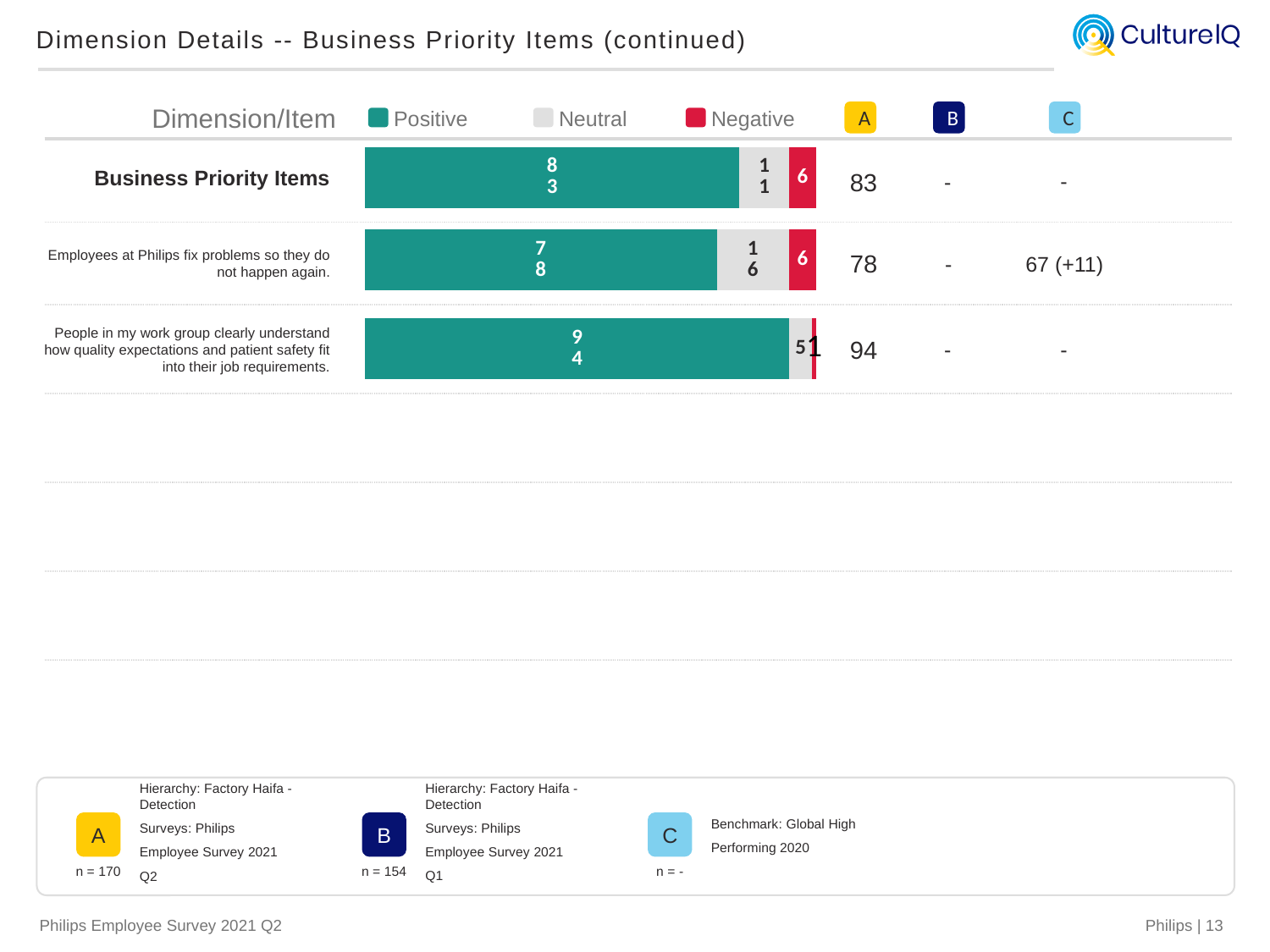
Which item has the highest Positive value? People in my work group clearly understand how quality expectations and patient safety fit into their job requirements. What is the Neutral value for "Employees at Philips fix problems so they do not happen again."? 16 Which item has the lowest Positive value? Employees at Philips fix problems so they do not happen again. How many rows (dimension/items) are plotted in the chart? 3 What value is shown in column C for "Employees at Philips fix problems so they do not happen again."? 67 (+11) What is the Positive value for "Business Priority Items"? 83 What is the total of the stacked bar for "Employees at Philips fix problems so they do not happen again."? 100 What kind of chart is shown on the slide? Stacked bar chart What is the difference between the Positive values for "People in my work group clearly understand how quality expectations and patient safety fit into their job requirements." and "Employees at Philips fix problems so they do not happen again."? 16 What is the Negative value for "People in my work group clearly understand how quality expectations and patient safety fit into their job requirements."? 1 How many series does the legend list? 3 Which has a larger Neutral value: "Business Priority Items" or "Employees at Philips fix problems so they do not happen again."? Employees at Philips fix problems so they do not happen again.